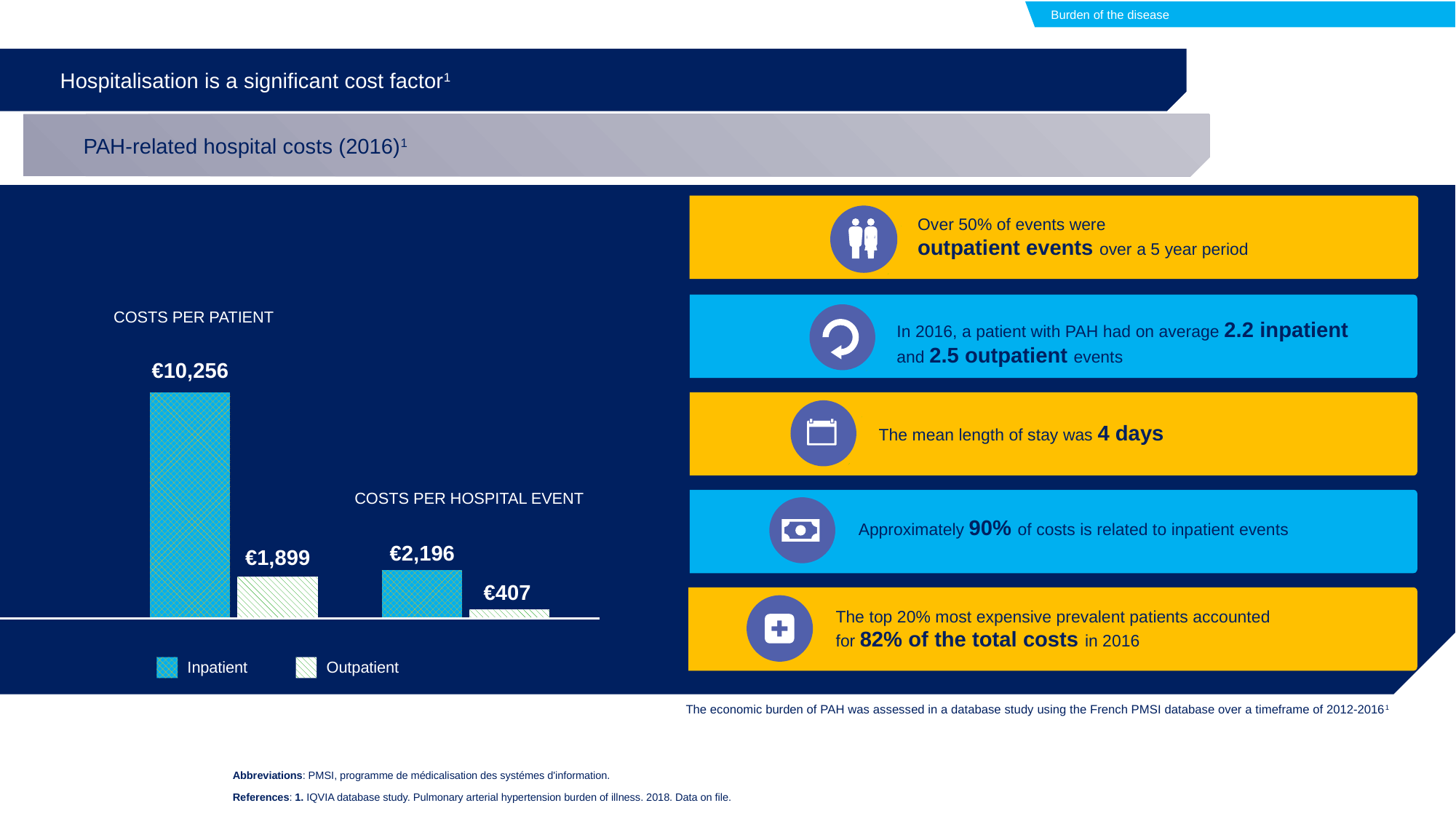
Which bar on the chart has the highest value? Inpatient costs per patient How many series does the chart legend list? 2 What are the two series named in the chart legend? Inpatient and Outpatient Which bar on the chart has the lowest value? Outpatient costs per hospital event What is the outpatient cost per patient shown on the chart? €1,899 What is the inpatient cost per hospital event shown on the chart? €2,196 What kind of chart is shown on the slide? Bar chart What is the outpatient cost per hospital event shown on the chart? €407 What is the inpatient cost per patient shown on the chart? €10,256 Which is larger: the outpatient cost per patient or the inpatient cost per hospital event? Inpatient cost per hospital event What is the difference between the inpatient and outpatient costs per hospital event? €1,789 What is the difference between the inpatient and outpatient costs per patient? €8,357